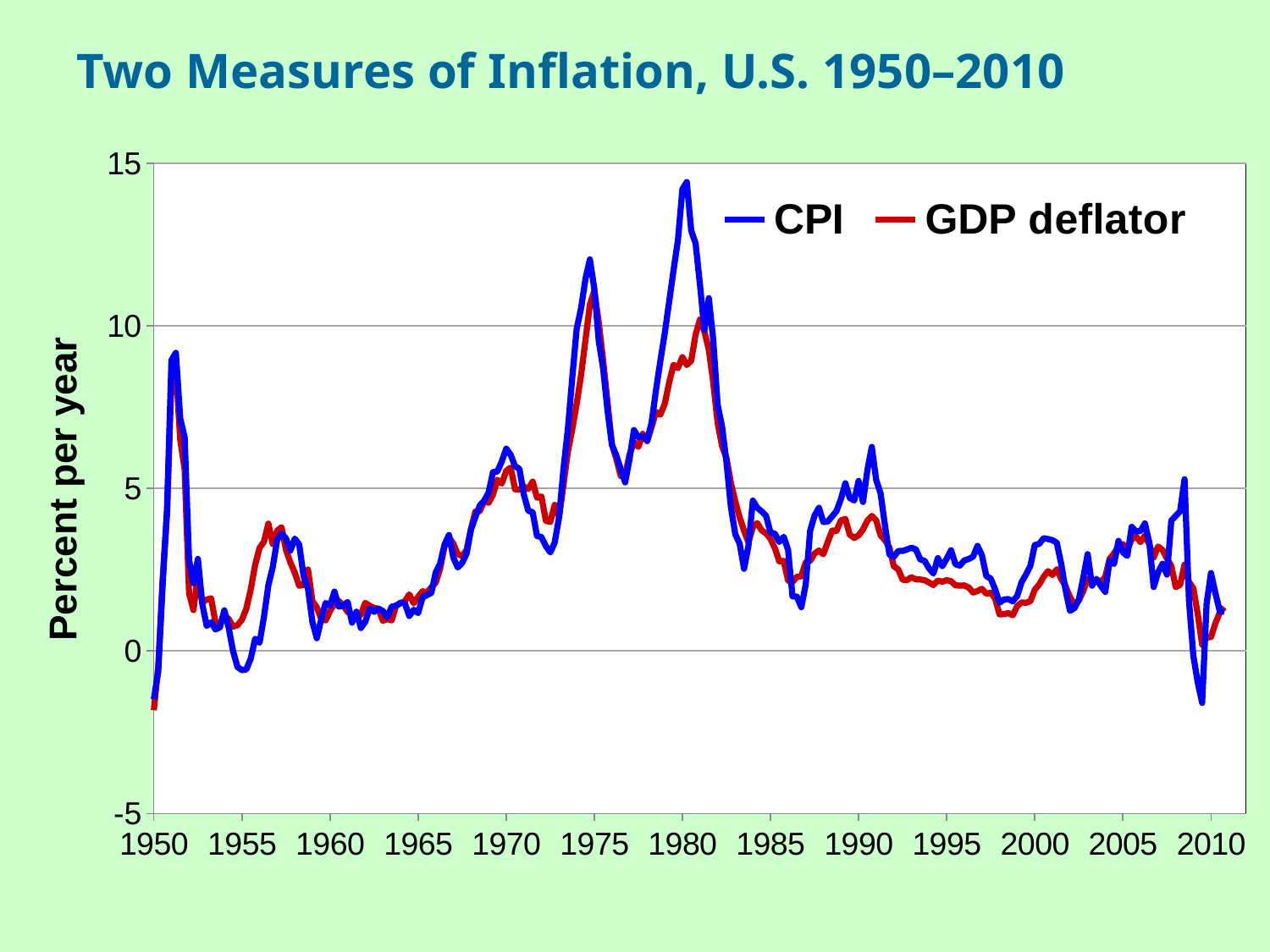
Which series reaches the highest peak on the chart? CPI What is the label on the vertical axis? Percent per year What is the title of the chart? Two Measures of Inflation, U.S. 1950–2010 Is the peak value of CPI around 1975 greater or less than 10? greater Do the inflation values generally rise or fall between 1980 and 1985? fall How many year labels are shown on the horizontal axis? 13 At the peak around 1980, which series is higher, CPI or GDP deflator? CPI Is the lowest value of CPI around 2009 greater or less than 0? less Is the value of GDP deflator around 1995 greater or less than 5? less What kind of chart is shown on the slide? line chart How many series does the legend list? 2